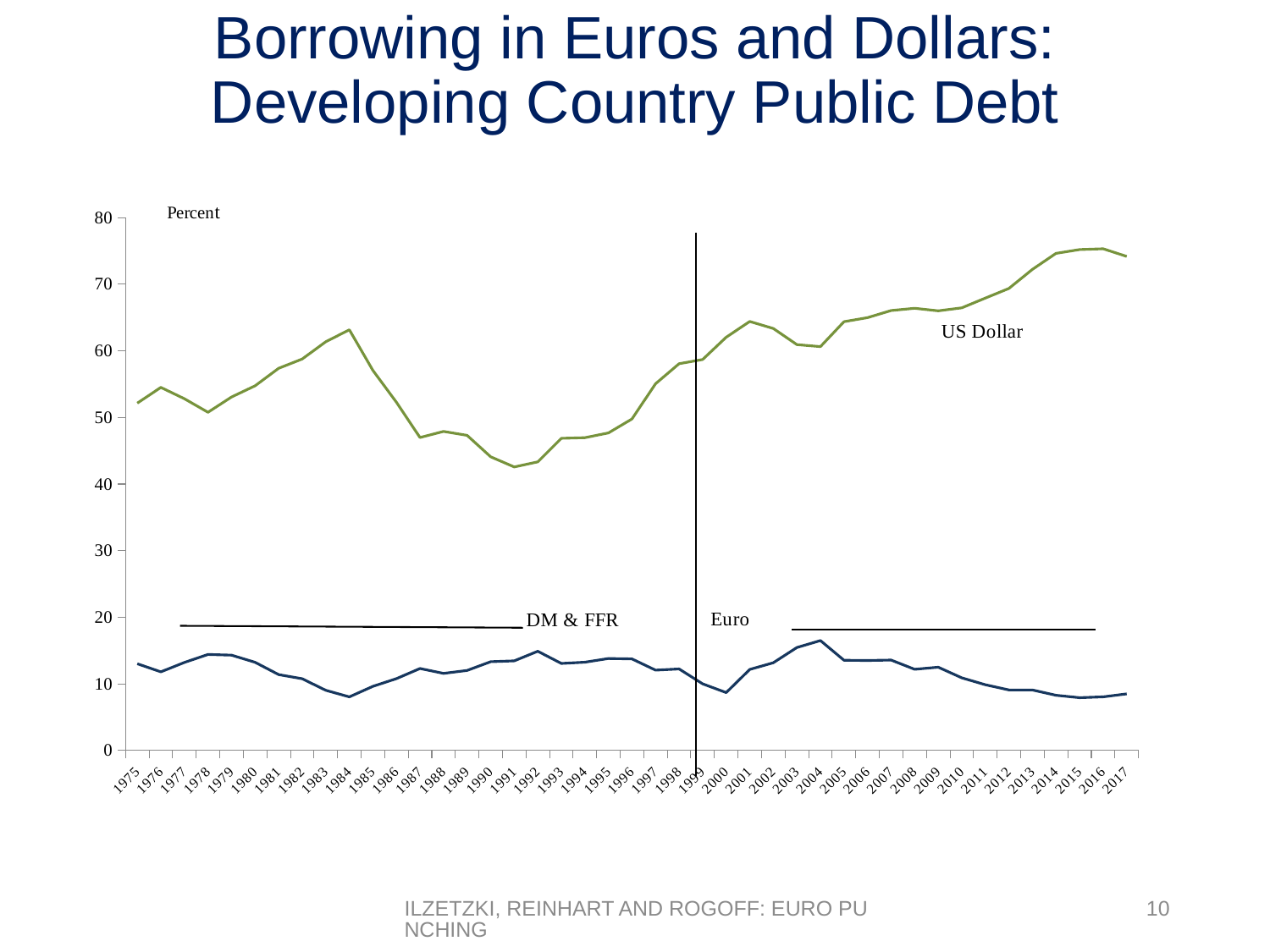
Is the value for US Dollar in 1991 greater or less than 50? less Does the US Dollar line rise or fall between 2009 and 2016? rise What kind of chart is shown on the slide? line chart Is the value for DM & FFR in 1992 greater or less than 10? greater In 2017, which is larger: the US Dollar share or the Euro share? US Dollar What unit label is shown at the top of the y axis? Percent How many series are plotted on the chart? 2 At which year is the vertical line separating DM & FFR from Euro drawn? 1999 Is the value for US Dollar in 2017 greater or less than 70? greater How many years are shown on the x axis of the chart? 43